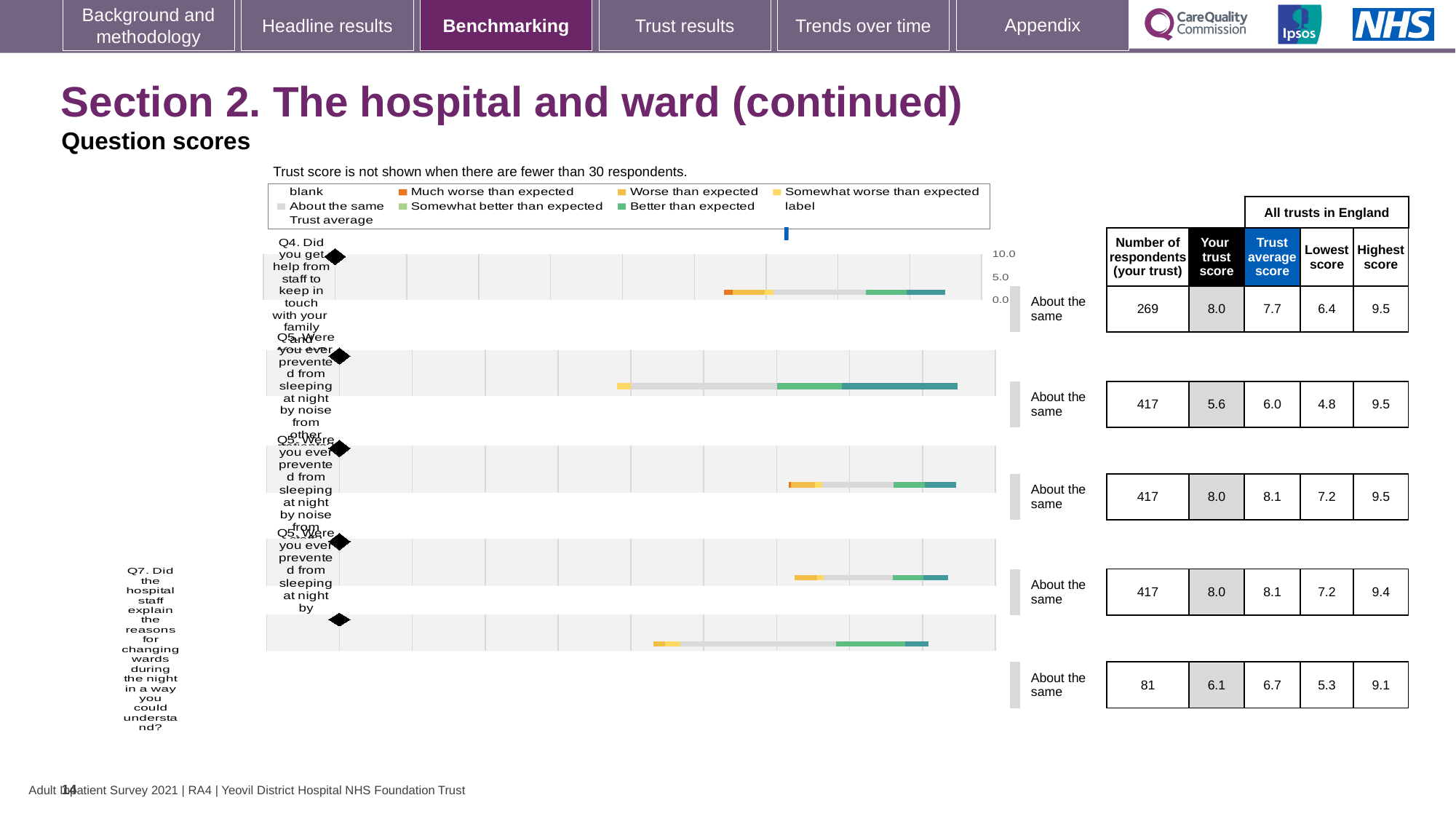
What benchmark category is shown for Q4 in the question scores chart? About the same Which question has the lowest number of respondents from the trust? Q7 For Q4, what is the difference between the highest score and the lowest score across all trusts in England? 3.1 What kind of chart is used to show the question scores on this slide? bar chart Is the trust's score for Q7 greater or less than 5.0? greater How many question rows are plotted in the question scores chart? 5 What is the 'Your trust score' for Q7 (explaining reasons for changing wards during the night)? 6.1 How many respondents from the trust answered Q4? 269 For Q7, what is the difference between the highest score and the lowest score across all trusts in England? 3.8 For Q4, which is larger: the trust's own score or the all-England trust average score? Your trust score What is the trust average score across all trusts in England for Q7? 6.7 What is the 'Your trust score' for Q4 (help from staff to keep in touch with family and friends)? 8.0